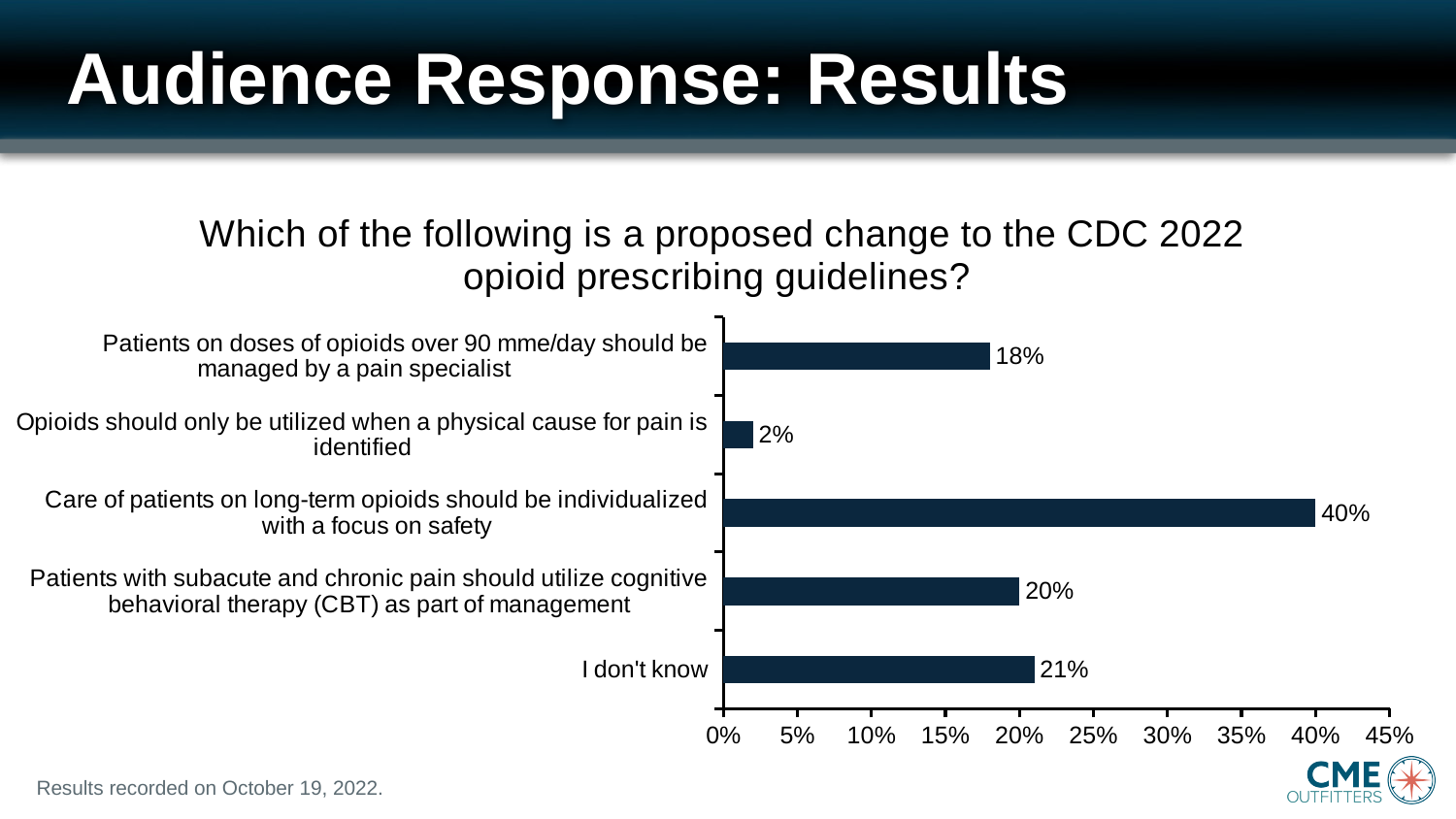
What percentage of respondents answered "I don't know"? 21% What percentage of respondents chose "Opioids should only be utilized when a physical cause for pain is identified"? 2% What percentage of respondents chose "Care of patients on long-term opioids should be individualized with a focus on safety"? 40% What is the difference in percentage points between the "Care of patients on long-term opioids should be individualized with a focus on safety" option and the "I don't know" option? 19% What question is the chart reporting audience responses to? Which of the following is a proposed change to the CDC 2022 opioid prescribing guidelines? What is the difference in percentage points between the "Patients with subacute and chronic pain should utilize cognitive behavioral therapy (CBT) as part of management" option and the "Patients on doses of opioids over 90 mme/day should be managed by a pain specialist" option? 2% Which received a higher percentage: "Patients on doses of opioids over 90 mme/day should be managed by a pain specialist" or "Patients with subacute and chronic pain should utilize cognitive behavioral therapy (CBT) as part of management"? Patients with subacute and chronic pain should utilize cognitive behavioral therapy (CBT) as part of management How many response options are shown in the chart? 5 What is the maximum value shown on the chart's horizontal axis? 45% Which response option received the lowest percentage? Opioids should only be utilized when a physical cause for pain is identified Which response option received the highest percentage? Care of patients on long-term opioids should be individualized with a focus on safety What type of chart is shown on the slide? Bar chart